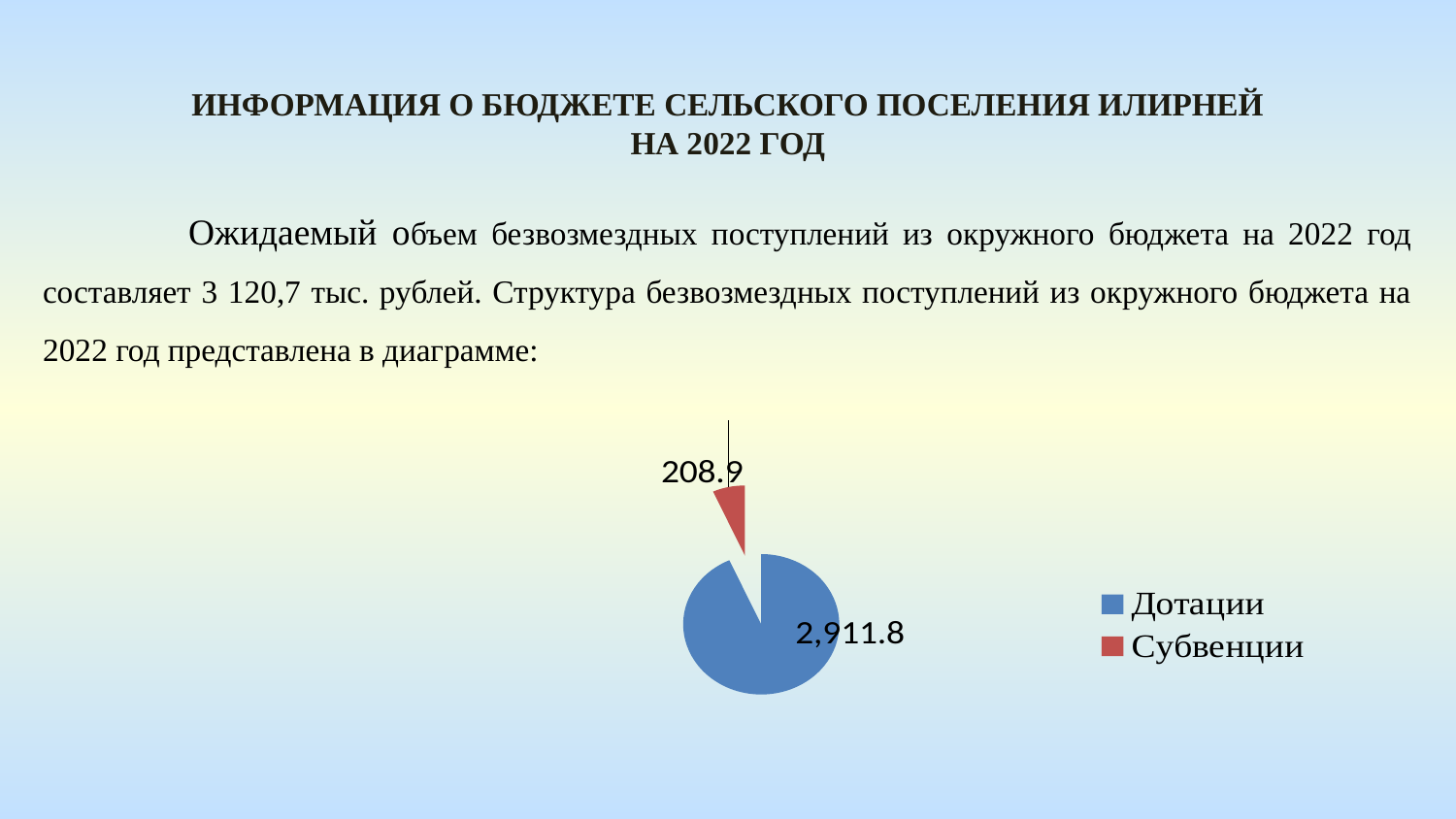
What colour is the Субвенции slice in the pie chart? Red What colour is the Дотации slice in the pie chart? Blue What is the total of the two values shown in the pie chart? 3,120.7 How many slices does the pie chart have? 2 Which category has the largest slice in the pie chart? Дотации Which category has the smallest slice in the pie chart? Субвенции What is the value for Дотации in the pie chart? 2,911.8 How many entries does the legend list? 2 Which is larger, Дотации or Субвенции? Дотации What kind of chart is shown on the slide? Pie chart What is the difference between the values for Дотации and Субвенции? 2,702.9 What is the value for Субвенции in the pie chart? 208.9